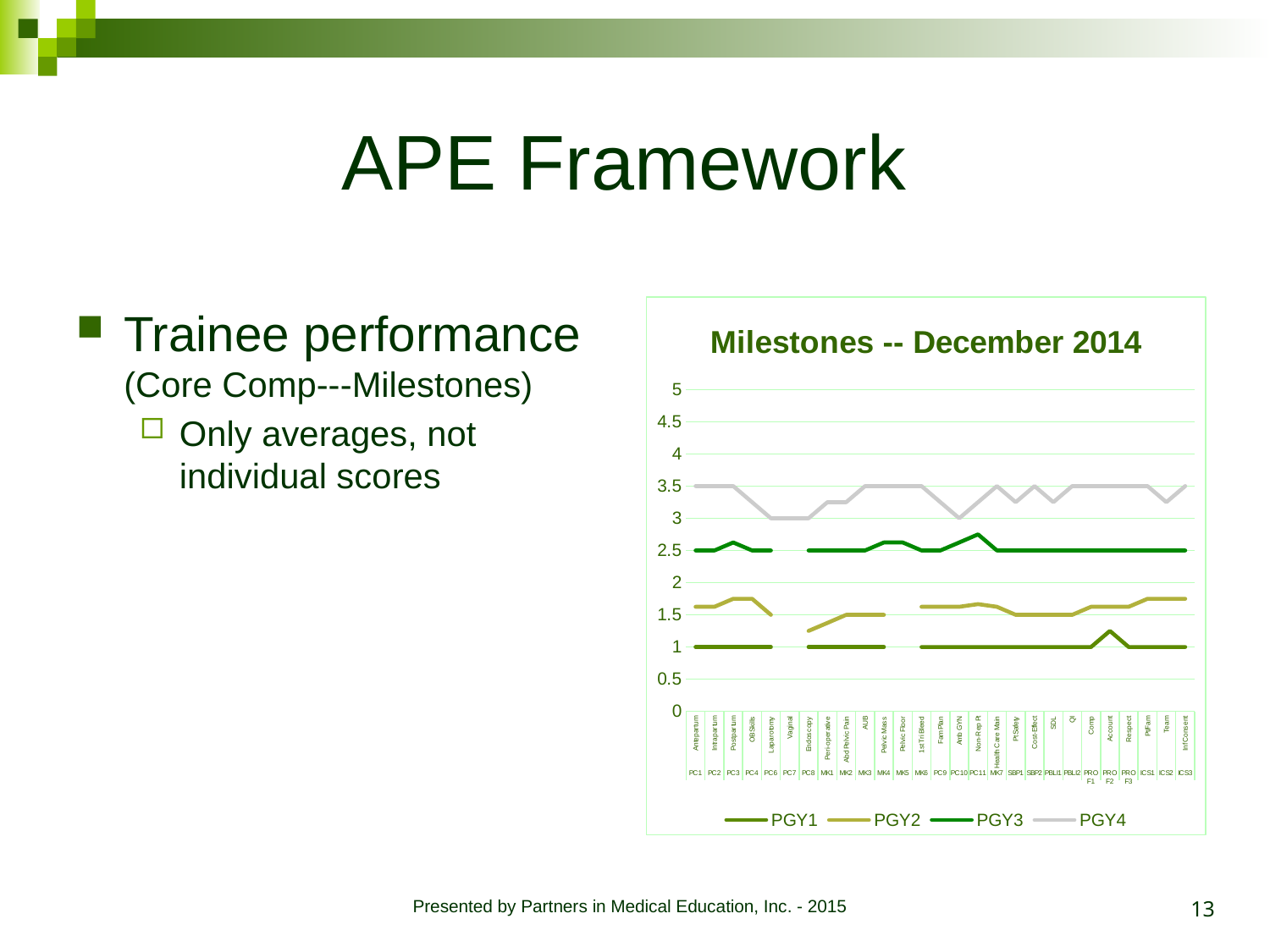
What is the value for PGY1 at PC1? 1 Which series has the highest values across the chart? PGY4 Is the value for PGY1 at PC1 greater or less than 2? less Which series are listed in the chart's legend? PGY1, PGY2, PGY3, PGY4 Which series is higher, PGY3 or PGY2? PGY3 What is the value for PGY3 at PC1? 2.5 Which series has the lowest values across the chart? PGY1 How many series does the chart's legend list? 4 What is the highest value shown on the chart's vertical axis? 5 What is the title of the chart? Milestones -- December 2014 What kind of chart is shown on the slide? line chart Is the value for PGY4 at PC1 greater or less than 3? greater